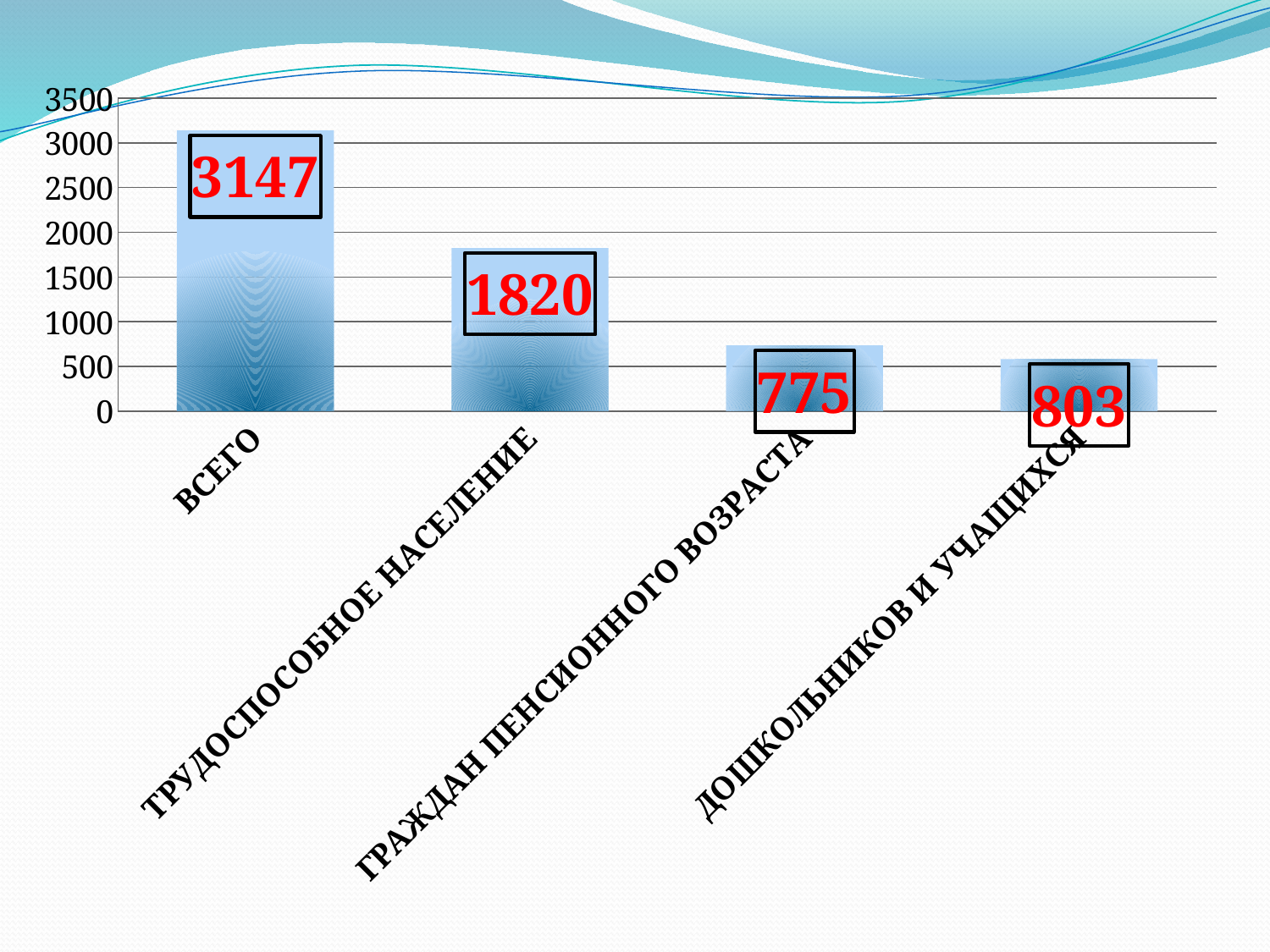
What kind of chart is shown on the slide? bar chart Is the value for ВСЕГО greater or less than 3000? greater Is the value for ТРУДОСПОСОБНОЕ НАСЕЛЕНИЕ greater or less than 1500? greater What value is shown for ВСЕГО? 3147 What is the highest value shown on the vertical axis? 3500 Which is larger, the value for ВСЕГО or the value for ТРУДОСПОСОБНОЕ НАСЕЛЕНИЕ? ВСЕГО How many categories are shown on the chart? 4 Which category has the highest value? ВСЕГО What value is shown for ТРУДОСПОСОБНОЕ НАСЕЛЕНИЕ? 1820 What is the difference between the values for ВСЕГО and ТРУДОСПОСОБНОЕ НАСЕЛЕНИЕ? 1327 What value is labelled on the bar for ДОШКОЛЬНИКОВ И УЧАЩИХСЯ? 803 What value is labelled on the bar for ГРАЖДАН ПЕНСИОННОГО ВОЗРАСТА? 775